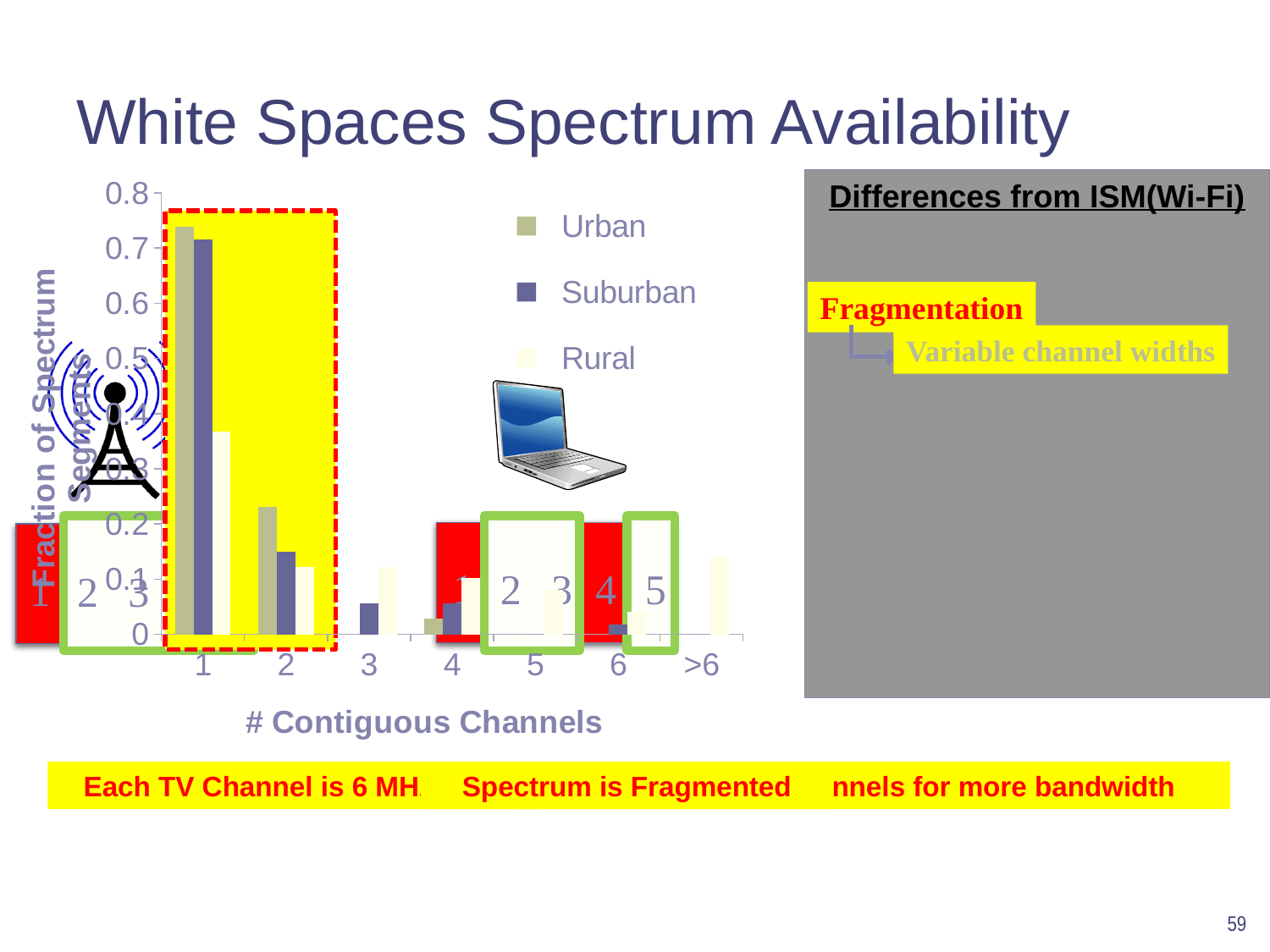
Do the Urban values rise or fall from category 1 to category 3? fall Is the Rural value for 1 contiguous channel greater or less than 0.5? less Which category has the highest Urban value? 1 For 1 contiguous channel, which is larger, the Urban value or the Rural value? Urban How many series does the chart legend list? 3 For 2 contiguous channels, which is larger, the Urban value or the Suburban value? Urban What is the title of the x axis of the chart? # Contiguous Channels Is the Urban value for 2 contiguous channels greater or less than 0.3? less Is the Urban value for 1 contiguous channel greater or less than 0.6? greater Which category has the highest Suburban value? 1 How many categories are shown along the x axis of the chart? 7 What kind of chart is shown on the slide? bar chart